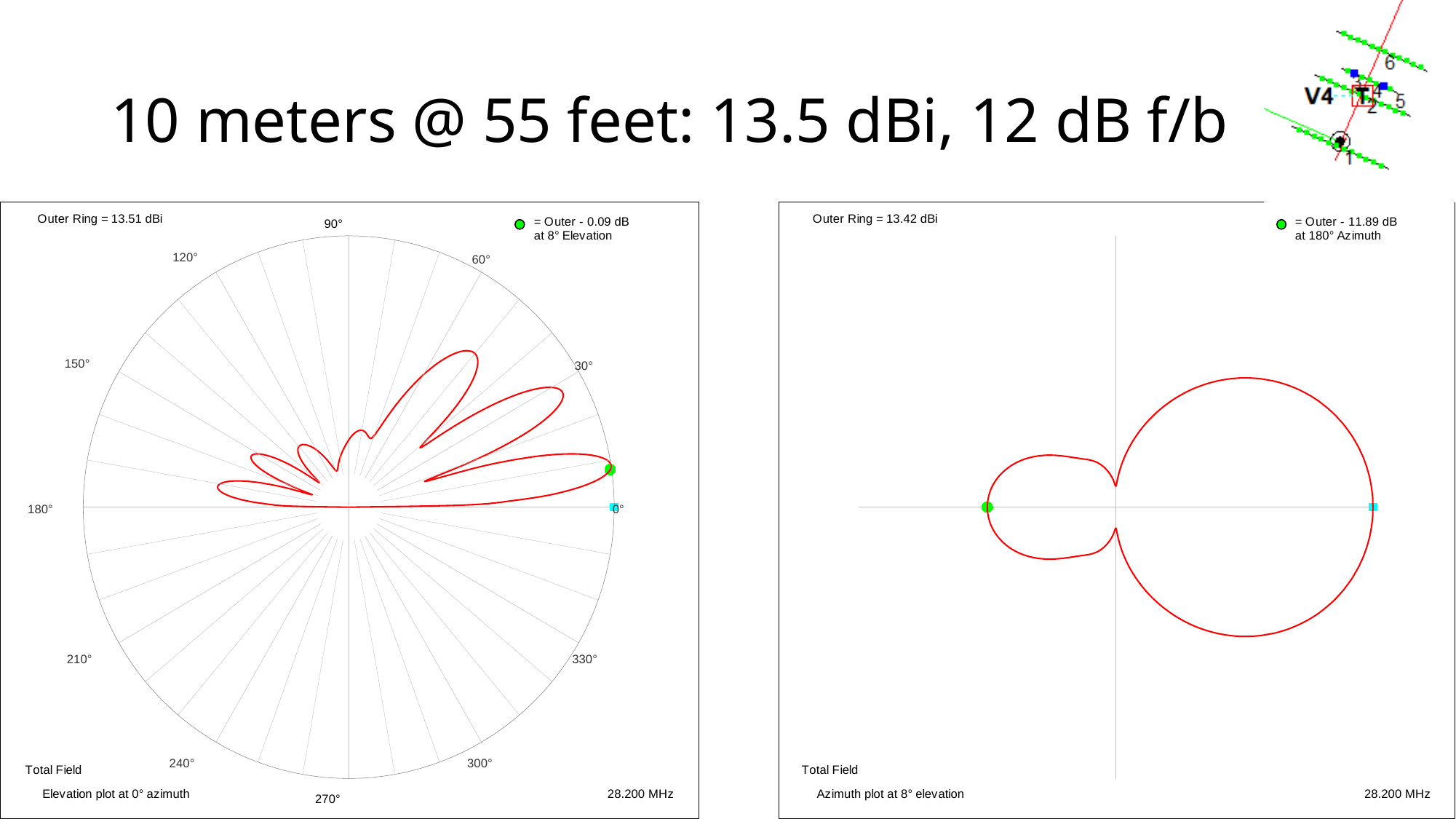
On the right chart (Azimuth plot at 8° elevation), what is the value of the outer ring? 13.42 dBi On the right chart, at what azimuth is the marked point located? 180° Azimuth On the right chart, how far below the outer ring is the marked point at 180° azimuth? 11.89 dB On the left chart (Elevation plot at 0° azimuth), what is the value of the outer ring? 13.51 dBi What is the difference between the outer ring values of the left and right charts? 0.09 dBi On the left chart, how far below the outer ring is the marked point? 0.09 dB What type of chart is shown on the left side of the slide? polar chart What field quantity is plotted on both charts, as labelled at the bottom left? Total Field Which chart has the higher outer ring value, the left elevation plot or the right azimuth plot? the left elevation plot What frequency is shown on the left chart? 28.200 MHz On the left chart, at what elevation angle is the marked point located? 8° Elevation What is the caption at the bottom left of the right chart describing the plot? Azimuth plot at 8° elevation